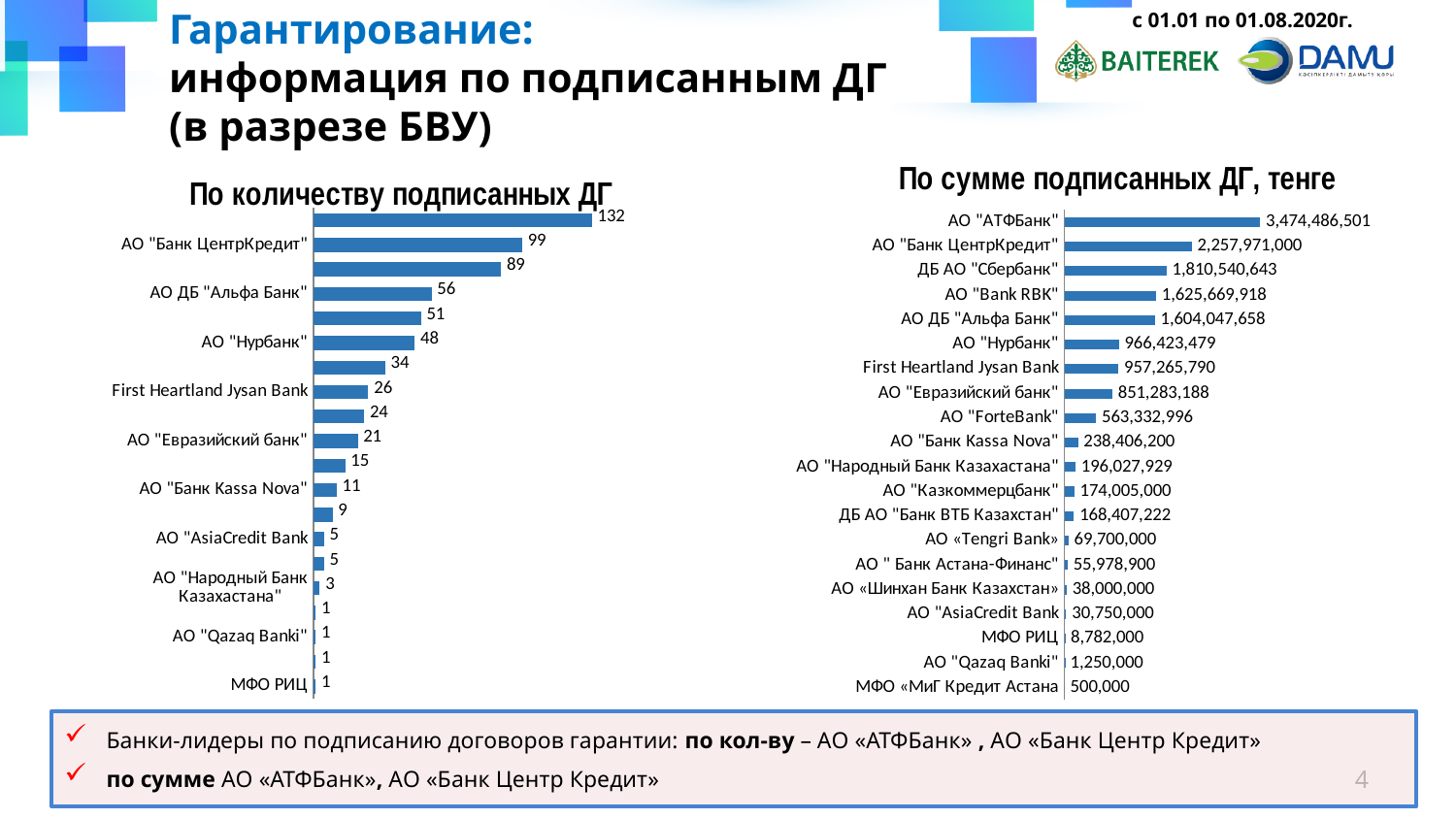
In the chart 'По сумме подписанных ДГ, тенге', which is larger: the value for АО "ForteBank" or the value for АО "Банк Kassa Nova"? АО "ForteBank" In the chart 'По сумме подписанных ДГ, тенге', what is the value for АО "АТФБанк"? 3,474,486,501 In the chart 'По сумме подписанных ДГ, тенге', what is the value for АО "Нурбанк"? 966,423,479 In the chart 'По количеству подписанных ДГ', what is the value for First Heartland Jysan Bank? 26 In the chart 'По сумме подписанных ДГ, тенге', which category has the lowest value? МФО «МиГ Кредит Астана» In the chart 'По количеству подписанных ДГ', what is the highest value shown? 132 In the chart 'По сумме подписанных ДГ, тенге', how many categories are plotted? 20 In the chart 'По сумме подписанных ДГ, тенге', which category has the highest value? АО "АТФБанк" In the chart 'По сумме подписанных ДГ, тенге', what is the difference between АО "Qazaq Banki" and МФО «МиГ Кредит Астана»? 750,000 In the chart 'По количеству подписанных ДГ', what is the value for АО "Банк ЦентрКредит"? 99 What type of chart is 'По количеству подписанных ДГ'? Bar chart In the chart 'По количеству подписанных ДГ', what is the difference between АО ДБ "Альфа Банк" and АО "Нурбанк"? 8